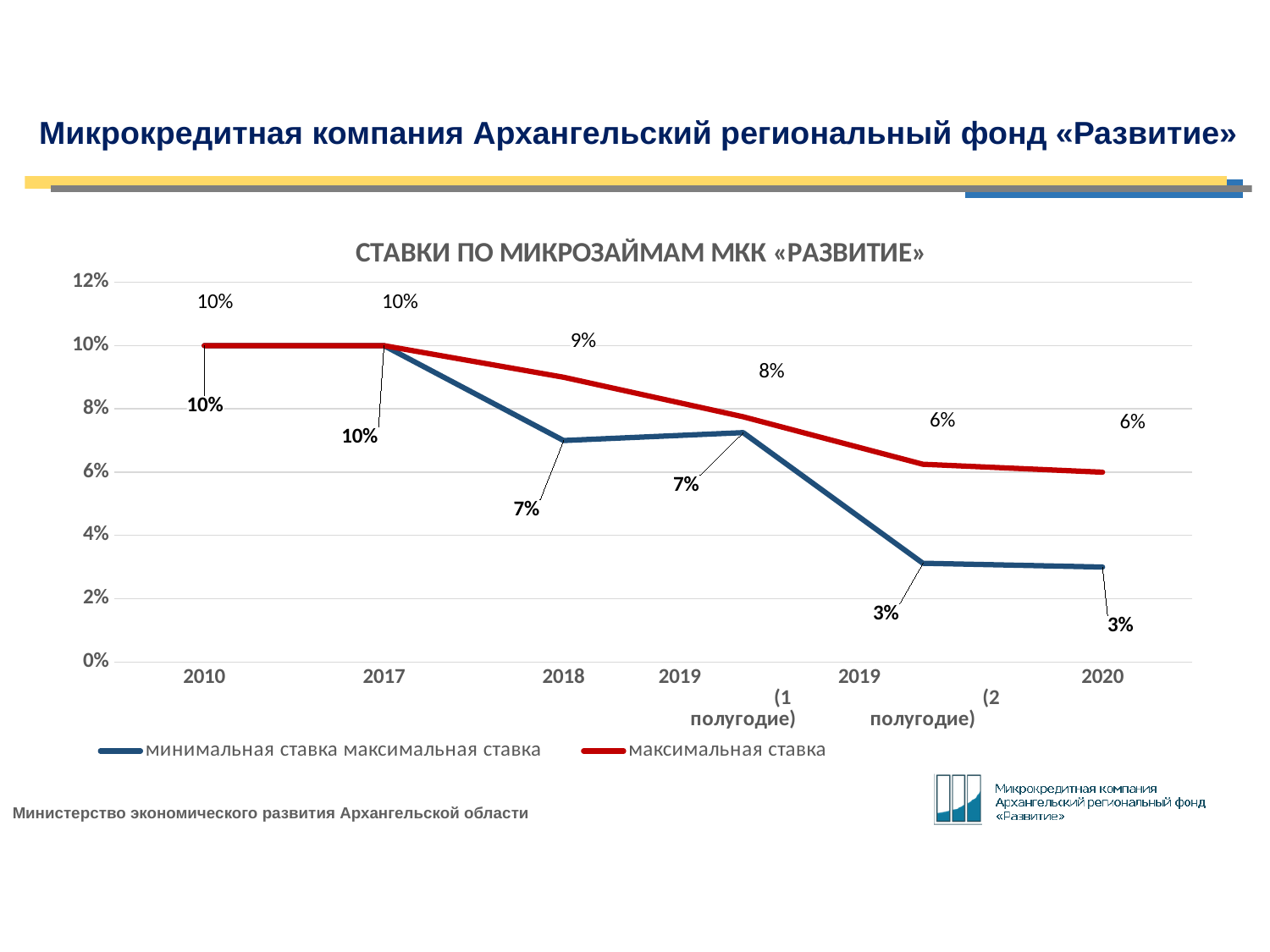
What is the value of the минимальная ставка series for 2020? 3% What is the value of the максимальная ставка series for 2019 (2 полугодие)? 6% In which category does the минимальная ставка series reach its lowest value? 2020 What is the value of the минимальная ставка series for 2018? 7% What kind of chart is shown on the slide? line chart Do the values of the максимальная ставка series rise or fall from 2017 to 2020? fall How many categories are shown on the x axis? 6 How many series does the legend list? 2 What is the value of the максимальная ставка series for 2018? 9% What is the difference between the максимальная ставка and минимальная ставка values for 2020? 3% Which is larger for 2018: the максимальная ставка value or the минимальная ставка value? максимальная ставка